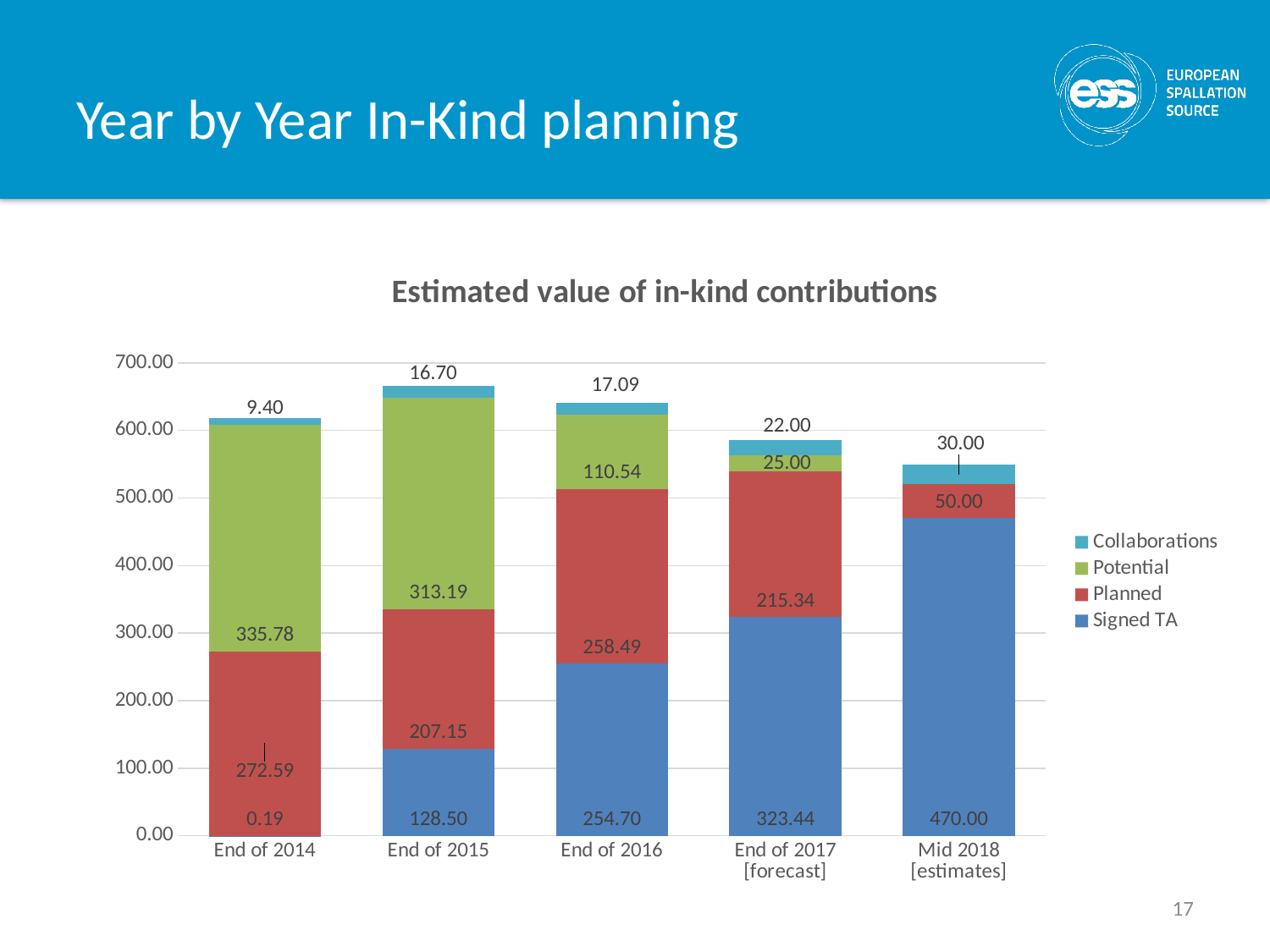
Do the Signed TA values rise or fall from End of 2014 to Mid 2018 [estimates]? Rise What is the Collaborations value for Mid 2018 [estimates]? 30.00 Which has the larger Planned value, End of 2015 or End of 2016? End of 2016 How many series does the legend list? 4 What is the Signed TA value for End of 2016? 254.70 How many categories are shown on the x axis? 5 Which category has the highest Potential value? End of 2014 What is the difference between the Signed TA values for End of 2017 [forecast] and End of 2016? 68.74 What is the Potential value for End of 2015? 313.19 What kind of chart is shown on the slide? Stacked bar chart Which category has the highest Signed TA value? Mid 2018 [estimates] What is the title of the chart? Estimated value of in-kind contributions